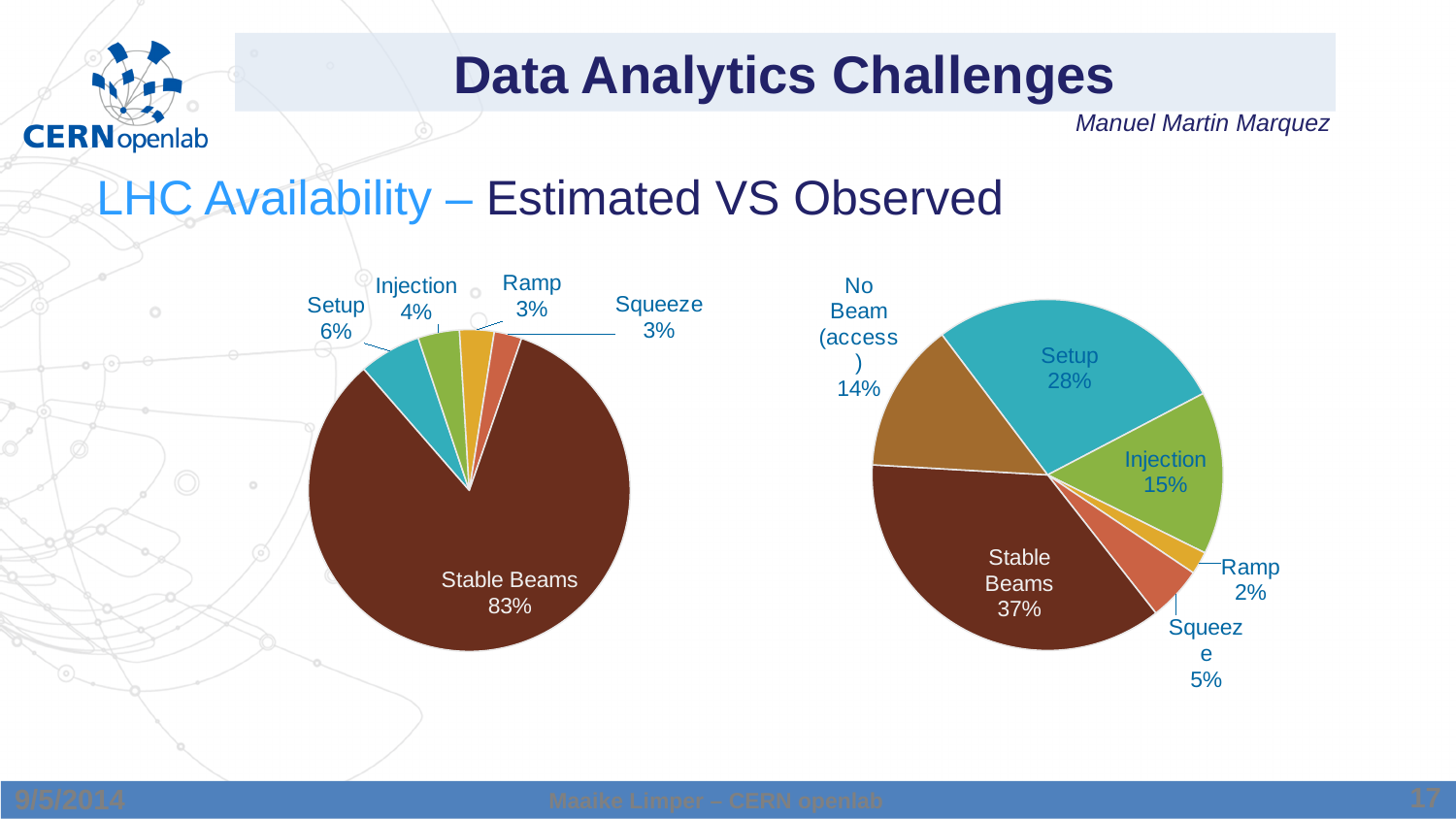
In the left pie chart, which category has the largest share? Stable Beams What type of chart is shown on the left of the slide? Pie chart In the right pie chart, which category has the smallest share? Ramp In the left pie chart, what share does Setup have? 6% In the right pie chart, what share does No Beam (access) have? 14% In the right pie chart, which category has the largest share? Stable Beams In the right pie chart, which is larger: the share for Injection or the share for Squeeze? Injection How many slices does the left pie chart have? 5 What is the difference between the Stable Beams share in the left pie chart and the Stable Beams share in the right pie chart? 46% In the left pie chart, what share does Stable Beams have? 83% In the right pie chart, what share does Setup have? 28% How many slices does the right pie chart have? 6